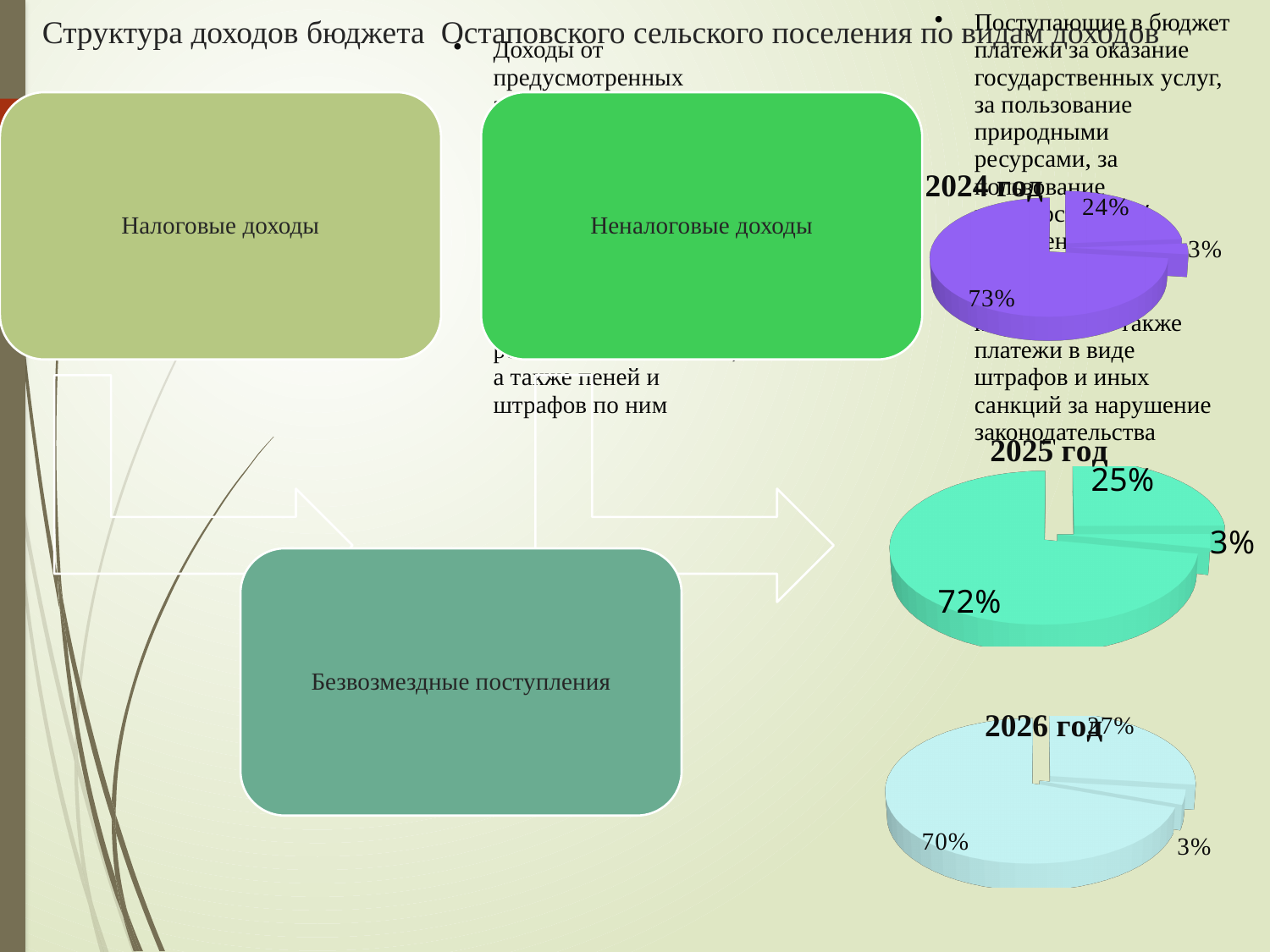
How many pie charts are shown on the slide? 3 In the "2026 год" pie chart, what is the share of the largest slice? 70% In the "2025 год" pie chart, what is the difference between the largest slice and the second-largest slice? 47% What kind of chart is the "2024 год" chart? pie chart In the "2025 год" pie chart, what is the share of the largest slice? 72% In the "2026 год" pie chart, what is the share of the second-largest slice? 27% Which chart has the larger largest slice, "2024 год" or "2026 год"? 2024 год How many slices does the "2025 год" pie chart have? 3 In the "2024 год" pie chart, what is the share of the largest slice? 73% What is the title of the pie chart at the bottom of the slide? 2026 год In the "2026 год" pie chart, what is the share of the smallest slice? 3% In the "2024 год" pie chart, what is the share of the smallest slice? 3%